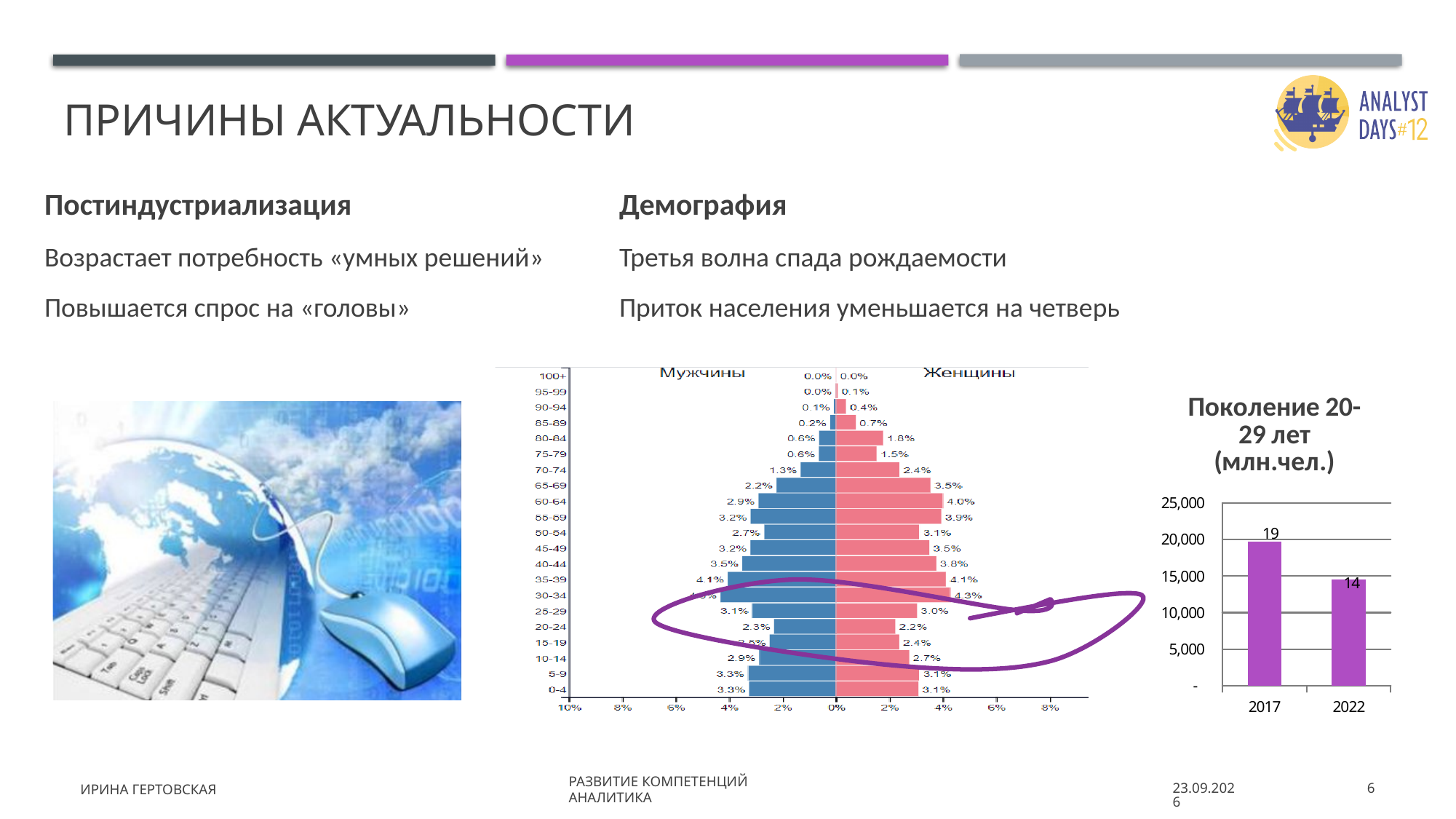
In the population pyramid chart (Мужчины / Женщины), what is the difference between the women's and men's values in the 60-64 age group? 1.1% In the population pyramid chart (Мужчины / Женщины), which is larger in the 65-69 age group: the value for men or the value for women? women (Женщины) What kind of chart is the chart titled 'Поколение 20-29 лет (млн.чел.)'? bar chart In the bar chart titled 'Поколение 20-29 лет (млн.чел.)', do the values rise or fall from 2017 to 2022? fall In the bar chart titled 'Поколение 20-29 лет (млн.чел.)', what is the difference between the 2017 and 2022 values? 5 In the bar chart titled 'Поколение 20-29 лет (млн.чел.)', what is the value for 2017? 19 In the bar chart titled 'Поколение 20-29 лет (млн.чел.)', what is the value for 2022? 14 In the population pyramid chart (Мужчины / Женщины), what is the value for men (Мужчины) in the 0-4 age group? 3.3% In the population pyramid chart (Мужчины / Женщины), what is the value for women (Женщины) in the 60-64 age group? 4.0% In the bar chart titled 'Поколение 20-29 лет (млн.чел.)', how many years are shown on the x axis? 2 In the bar chart titled 'Поколение 20-29 лет (млн.чел.)', which year has the higher value? 2017 In the population pyramid chart (Мужчины / Женщины), how many series (groups) are shown? 2